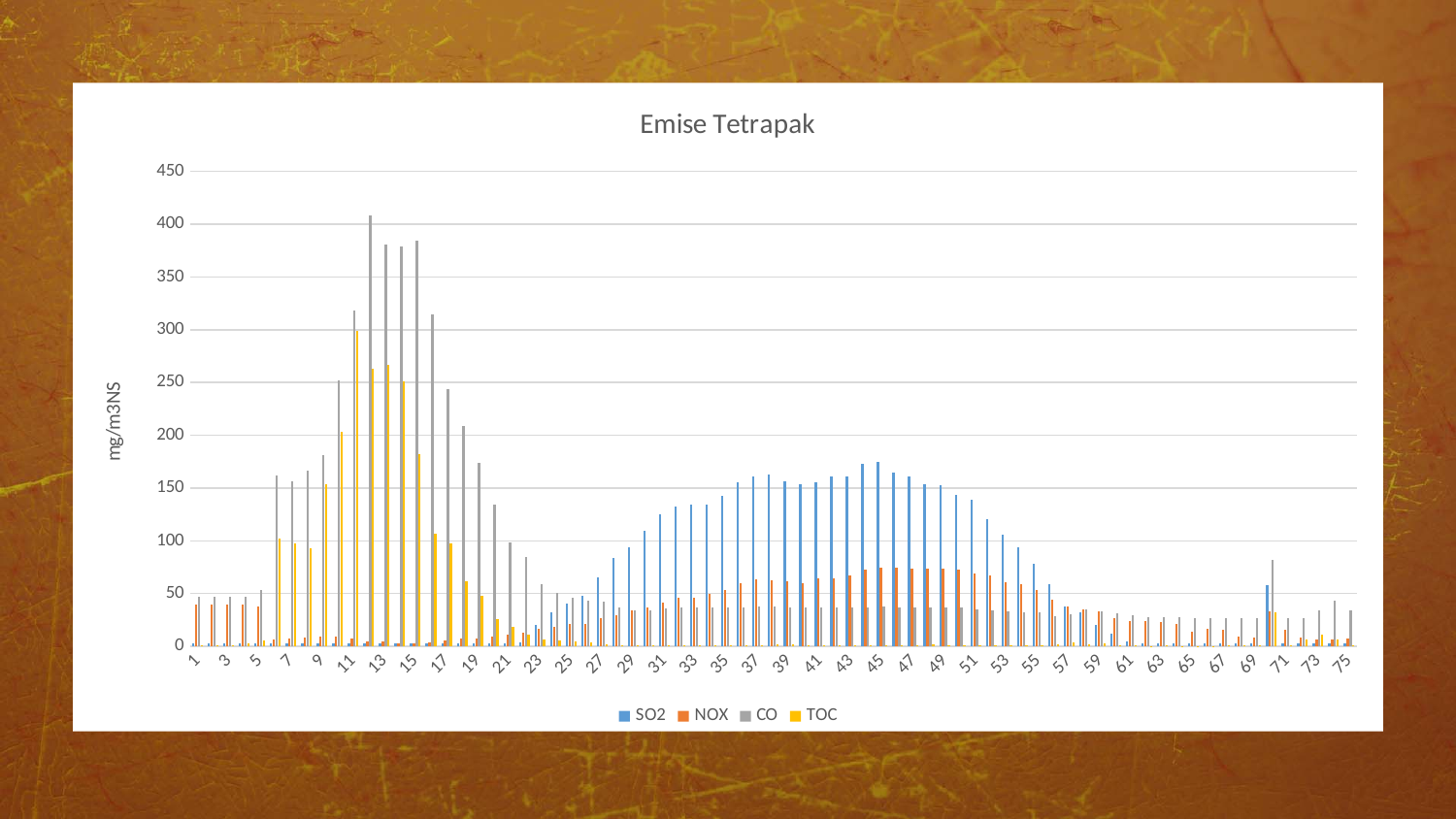
Which series reaches the highest value on the chart? CO How many series does the legend list? 4 Which is larger: the CO value at point 12 or the SO2 value at point 45? CO at point 12 What is the label on the vertical axis? mg/m3NS Is the NOX value at point 45 greater or less than 50? greater Is the SO2 value at point 30 greater or less than 150? less Is the CO value at point 12 greater or less than 350? greater What is the title of the chart? Emise Tetrapak What kind of chart is shown on the slide? bar chart What is the highest value shown on the vertical axis? 450